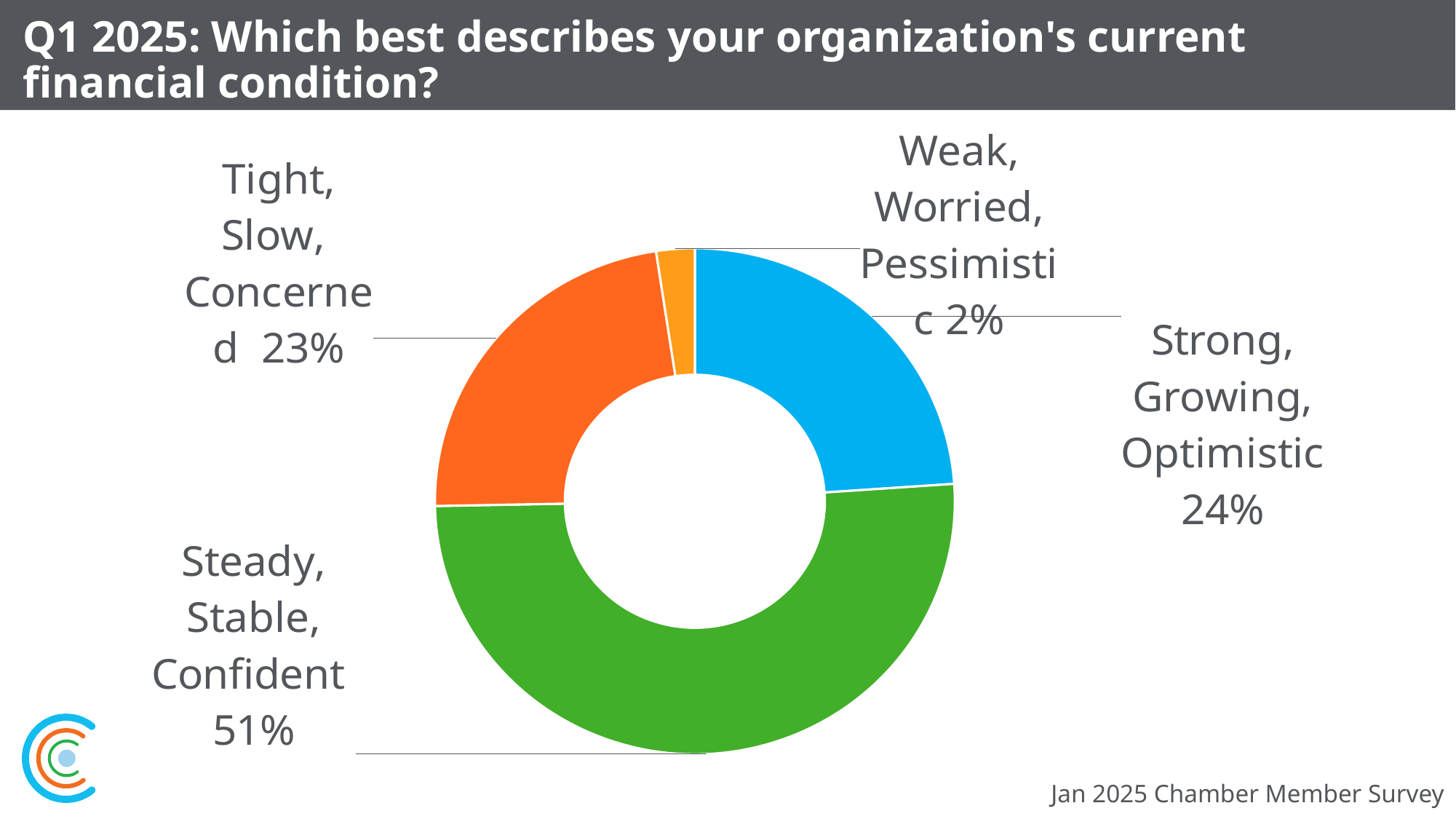
What is the difference in percentage points between Tight, Slow, Concerned and Weak, Worried, Pessimistic? 21 percentage points What colour is the Steady, Stable, Confident segment? Green What percentage of respondents chose Weak, Worried, Pessimistic? 2% What percentage of respondents chose Tight, Slow, Concerned? 23% How many categories are shown in the chart? 4 What share of respondents described their organization's financial condition as Steady, Stable, Confident? 51% Which is larger: the share for Strong, Growing, Optimistic or the share for Tight, Slow, Concerned? Strong, Growing, Optimistic What percentage of respondents chose Strong, Growing, Optimistic? 24% What kind of chart is shown on the slide? Doughnut (pie) chart Which category has the smallest share of the chart? Weak, Worried, Pessimistic What is the difference in percentage points between Steady, Stable, Confident and Strong, Growing, Optimistic? 27 percentage points Which category has the largest share of the chart? Steady, Stable, Confident